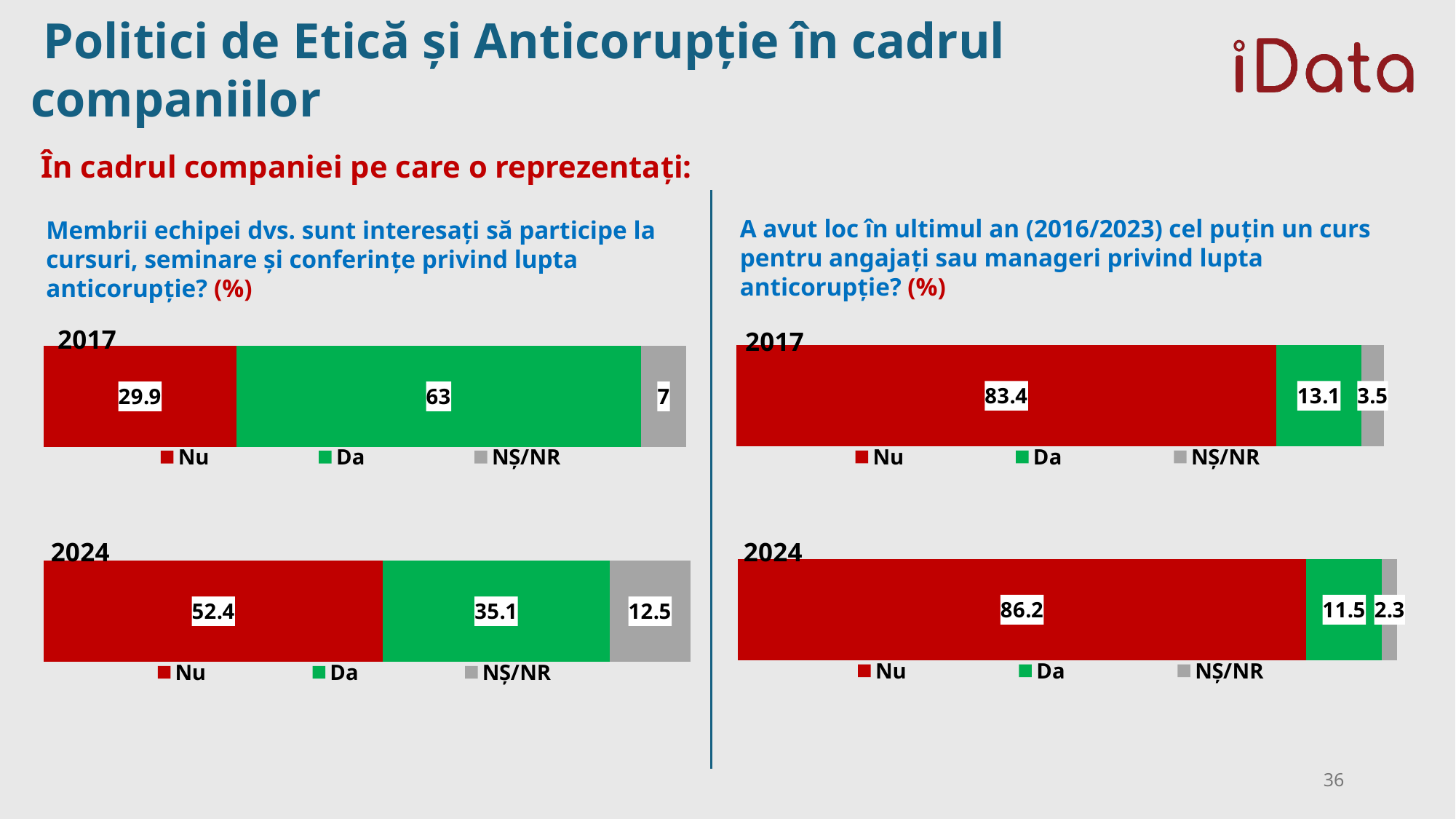
What kind of chart is used for the 2024 data on the right-hand side of the slide? Stacked bar chart In the right-hand chart for 2024 (at least one anticorruption course held in the last year), what is the value for "NȘ/NR"? 2.3 In the right-hand chart for 2024, which category has the lowest value? NȘ/NR Which colour represents "Nu" in the charts on the slide? Red How many series does the legend list in the left-hand chart for 2017? 3 In the right-hand chart for 2017, what is the total of the three stacked segments? 100 In the left-hand chart for 2024, what is the difference between the "Nu" and "Da" values? 17.3 In the right-hand chart for 2017 (at least one anticorruption course held in the last year), what is the value for "Nu"? 83.4 In the left-hand chart for 2017 (team members interested in anticorruption courses), what is the value for "Da"? 63 In the right-hand chart, which is larger: the "Da" value for 2017 or the "Da" value for 2024? 2017 In the left-hand chart for 2024 (team members interested in anticorruption courses), what is the value for "Nu"? 52.4 In the left-hand chart for 2017, which category has the highest value? Da